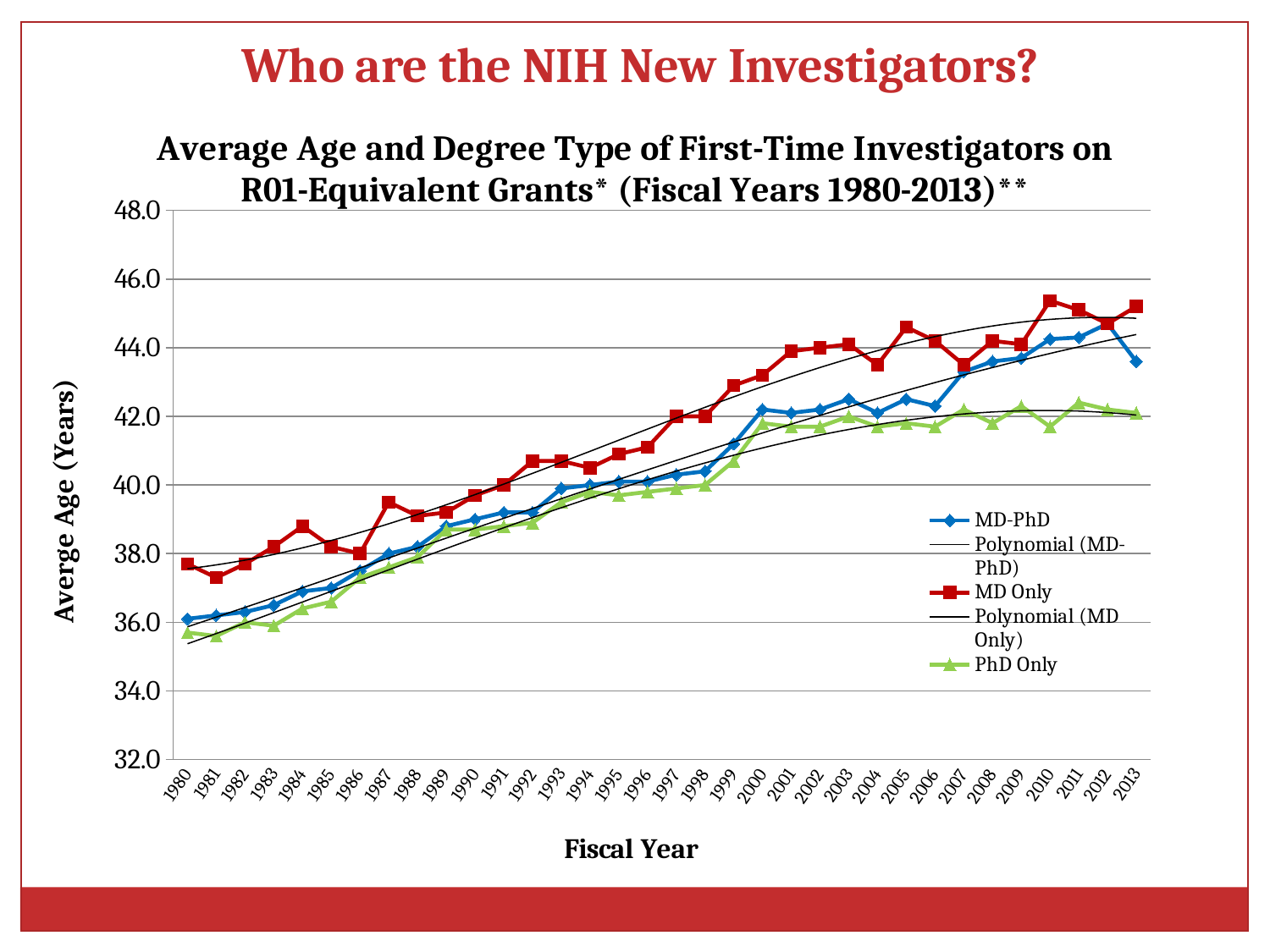
Does the MD Only series generally rise or fall from 1980 to 2013? rise Is the MD Only value for 2010 greater or less than 44.0? greater In 1980, which is larger: the MD Only value or the MD-PhD value? MD Only Is the MD Only value for 2005 greater or less than 44.0? greater Is the MD-PhD value for 1980 greater or less than 38.0? less What kind of chart is shown on the slide? line chart In 2013, which is larger: the MD Only value or the PhD Only value? MD Only What is the title of the x axis? Fiscal Year How many fiscal years are plotted along the x axis? 34 How many entries does the chart legend list? 5 Which series has the lowest value in 2013? PhD Only